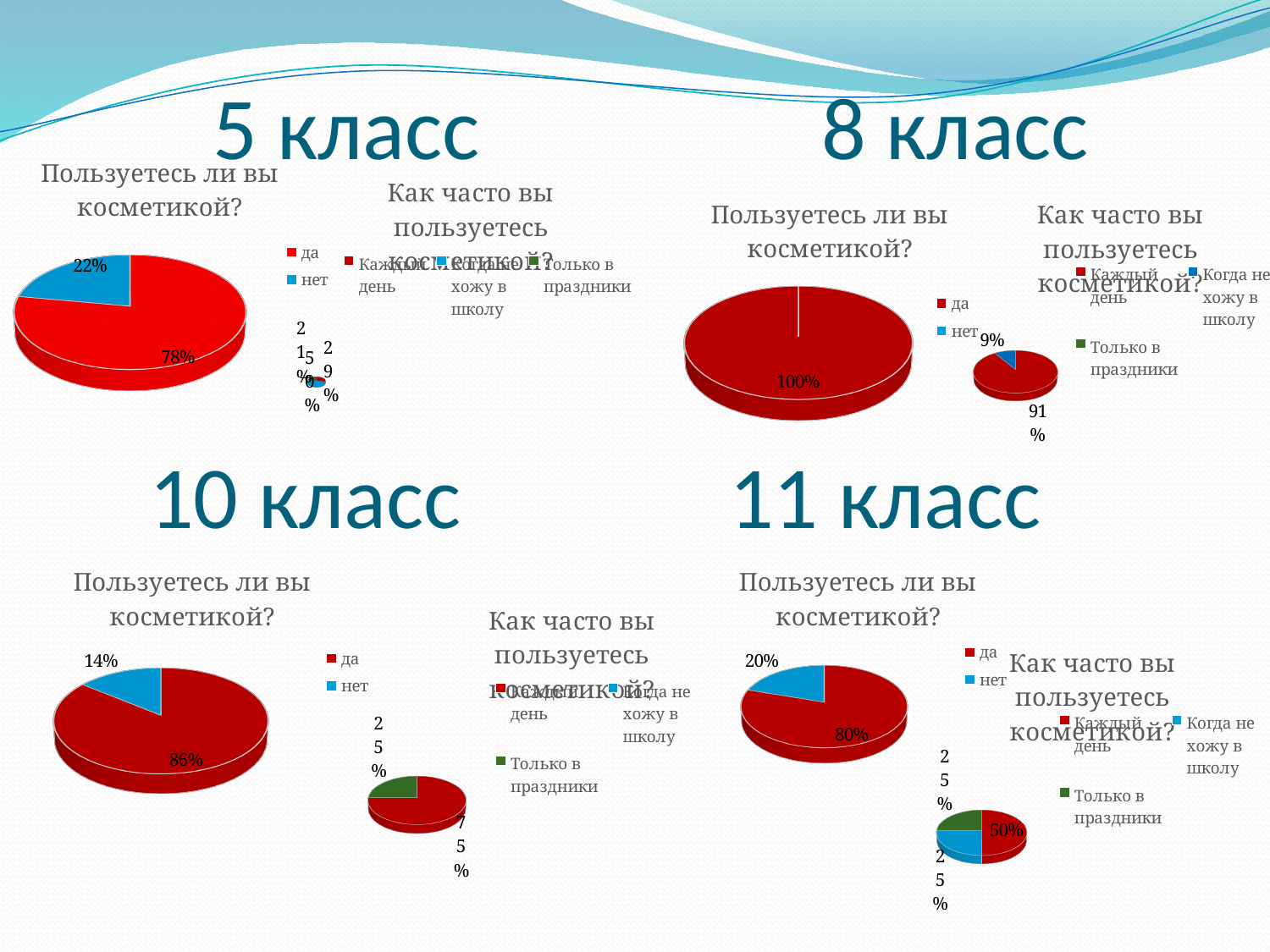
In the 8 класс chart 'Как часто вы пользуетесь косметикой?', what percentage is shown for 'Когда не хожу в школу'? 9% In the 8 класс chart 'Как часто вы пользуетесь косметикой?', what percentage is shown for 'Каждый день'? 91% In the 5 класс chart 'Пользуетесь ли вы косметикой?', what percentage answered 'да'? 78% In the 11 класс chart 'Как часто вы пользуетесь косметикой?', what percentage is shown for 'Каждый день'? 50% In the 10 класс chart 'Пользуетесь ли вы косметикой?', which answer has the larger share, 'да' or 'нет'? да In the 8 класс chart 'Пользуетесь ли вы косметикой?', what percentage answered 'да'? 100% What type of chart is used for the 5 класс 'Пользуетесь ли вы косметикой?' chart? Pie chart How many entries does the legend of the 11 класс chart 'Как часто вы пользуетесь косметикой?' list? 3 In the 10 класс chart 'Как часто вы пользуетесь косметикой?', what percentage is shown for 'Только в праздники'? 25% In the 10 класс chart 'Пользуетесь ли вы косметикой?', what percentage answered 'нет'? 14% In the 11 класс chart 'Пользуетесь ли вы косметикой?', what is the difference between the 'да' and 'нет' shares? 60% In the 5 класс chart 'Пользуетесь ли вы косметикой?', what percentage answered 'нет'? 22%